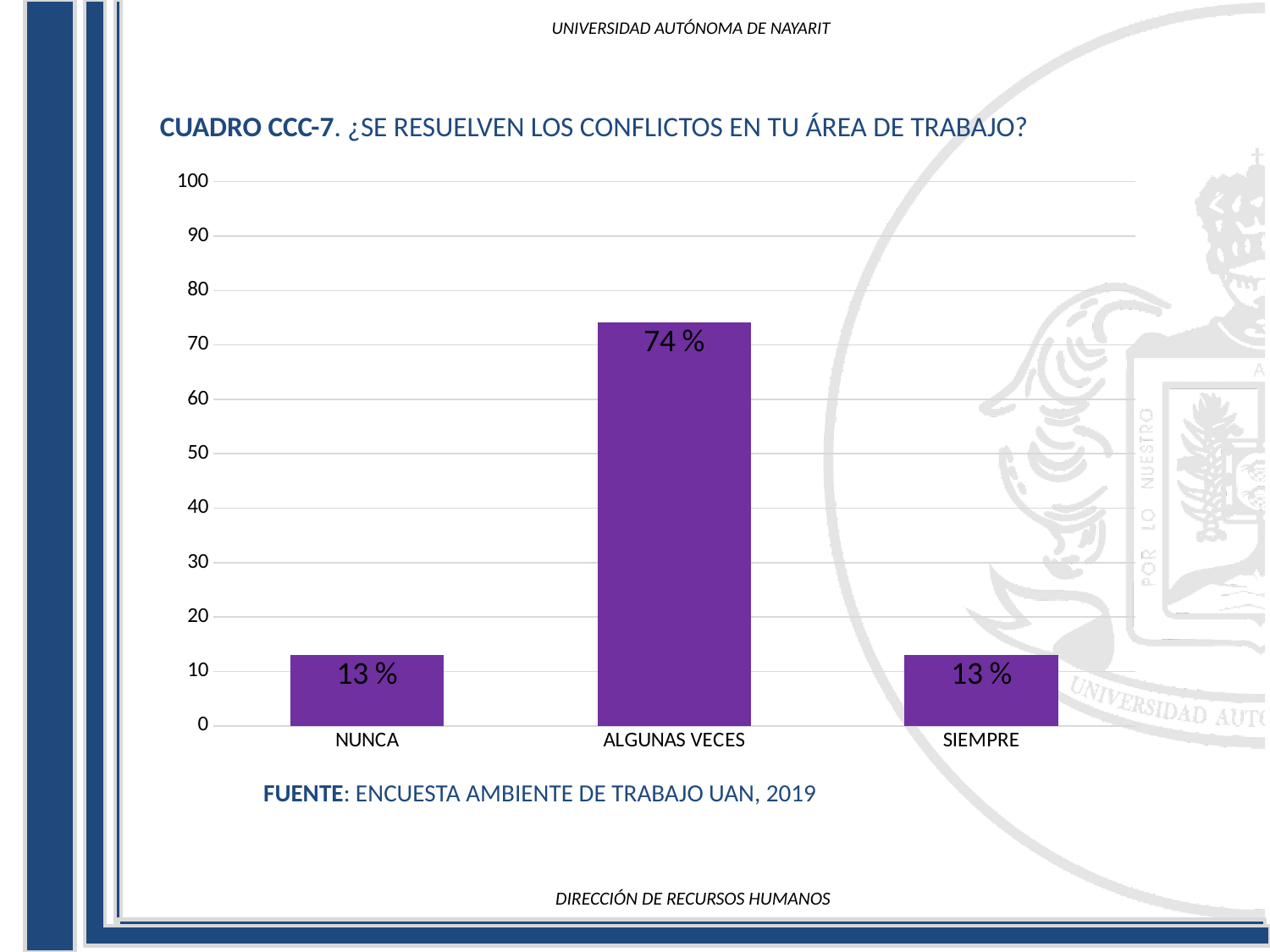
What is the value for SIEMPRE? 13 % What is the value for ALGUNAS VECES? 74 % What source is cited below the chart? ENCUESTA AMBIENTE DE TRABAJO UAN, 2019 What kind of chart is shown on the slide? bar chart Is the value for ALGUNAS VECES greater or less than 70? greater How many categories are shown on the x axis? 3 What is the value for NUNCA? 13 % Is the value for NUNCA greater or less than 20? less Which category has the highest value? ALGUNAS VECES Which is larger, the value for ALGUNAS VECES or the value for SIEMPRE? ALGUNAS VECES What is the title of the chart? CUADRO CCC-7. ¿SE RESUELVEN LOS CONFLICTOS EN TU ÁREA DE TRABAJO? What is the difference between the values for ALGUNAS VECES and NUNCA? 61 %